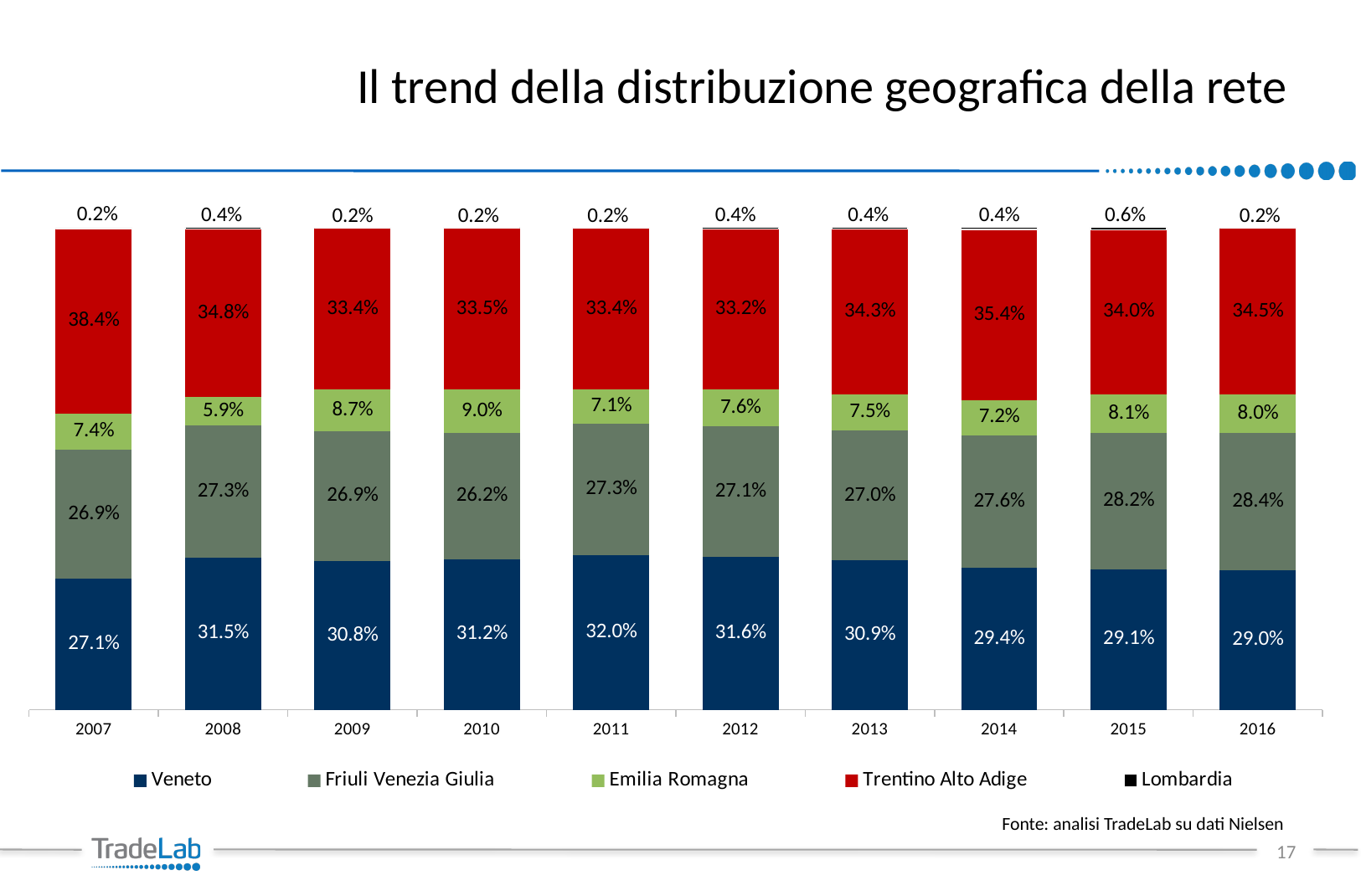
In which year is the Emilia Romagna value lowest? 2008 How many series does the legend list? 5 What is the difference between the Trentino Alto Adige values in 2007 and 2008? 3.6 percentage points What is the value for Emilia Romagna in 2010? 9.0% What is the value for Lombardia in 2015? 0.6% How many years are shown on the x axis? 10 In 2008, which is larger: the Veneto value or the Friuli Venezia Giulia value? Veneto What kind of chart is shown on the slide? Stacked bar chart In which year is the Trentino Alto Adige value highest? 2007 What is the value for Trentino Alto Adige in 2014? 35.4% In which year is the Veneto value highest? 2011 What is the value for Veneto in 2007? 27.1%